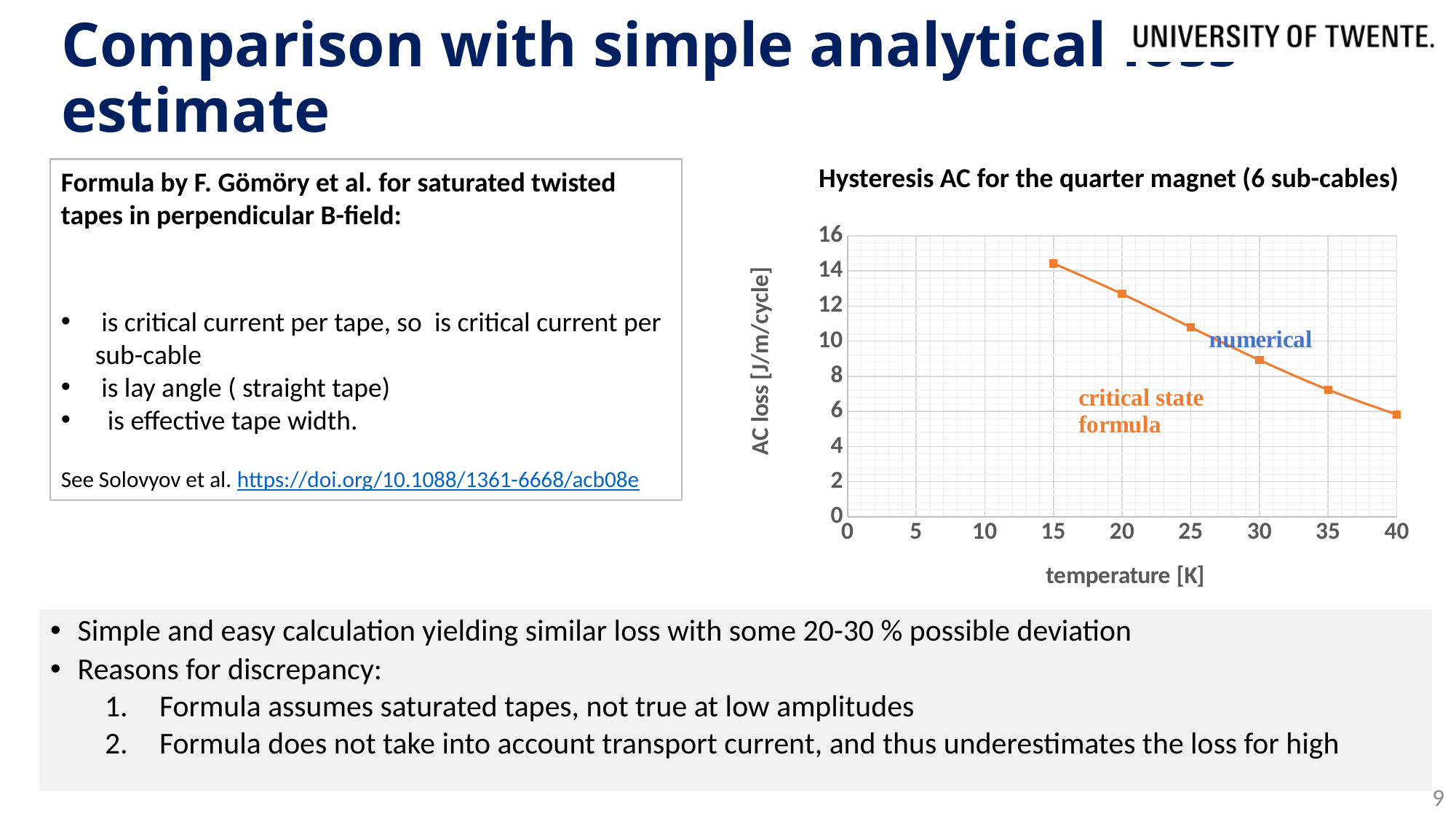
Is the AC loss at 35 K greater or less than 8 J/m/cycle? less What kind of chart is shown under the title 'Hysteresis AC for the quarter magnet (6 sub-cables)'? line chart What is the label of the y axis of the chart? AC loss [J/m/cycle] Do the plotted AC loss values rise or fall as temperature increases along the x axis? fall Is the AC loss at 25 K greater or less than 10 J/m/cycle? greater At which temperature is the plotted AC loss highest? 15 K What is the label of the x axis of the chart? temperature [K] Which has the larger AC loss: 20 K or 30 K? 20 K Is the AC loss at 15 K greater or less than 14 J/m/cycle? greater How many data points are plotted on the orange line? 6 At which temperature is the plotted AC loss lowest? 40 K